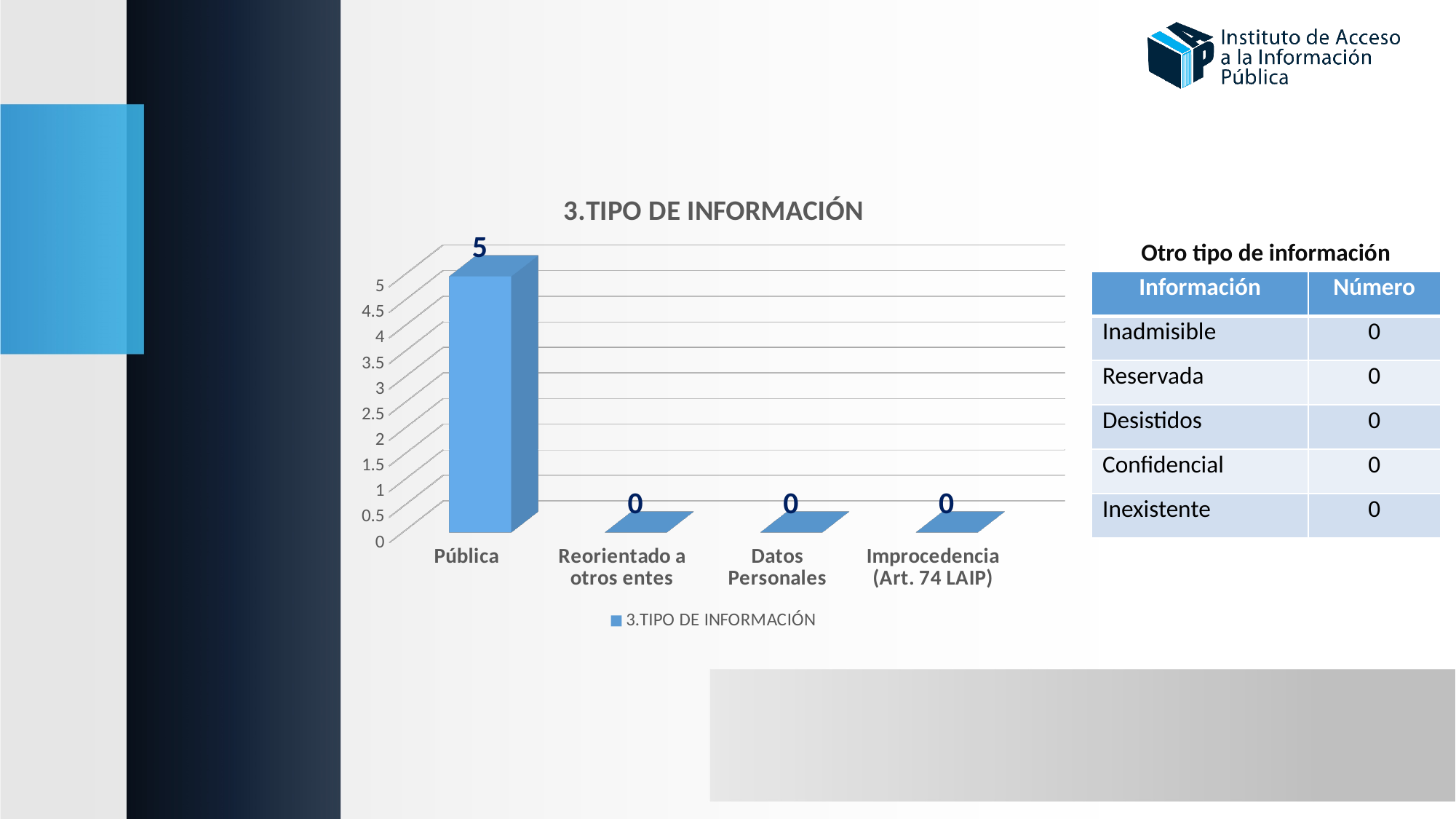
What is the value for Pública in the chart? 5 How many series does the chart legend list? 1 What is the title of the chart? 3.TIPO DE INFORMACIÓN Which is larger, the value for Pública or the value for Reorientado a otros entes? Pública What is the value for Improcedencia (Art. 74 LAIP)? 0 Which category has the highest value? Pública What kind of chart is shown on the slide? bar chart What is the value for Reorientado a otros entes? 0 Is the value for Pública greater or less than 3? greater What is the difference between the values for Pública and Datos Personales? 5 What is the value for Datos Personales? 0 How many categories are shown on the x axis of the chart? 4